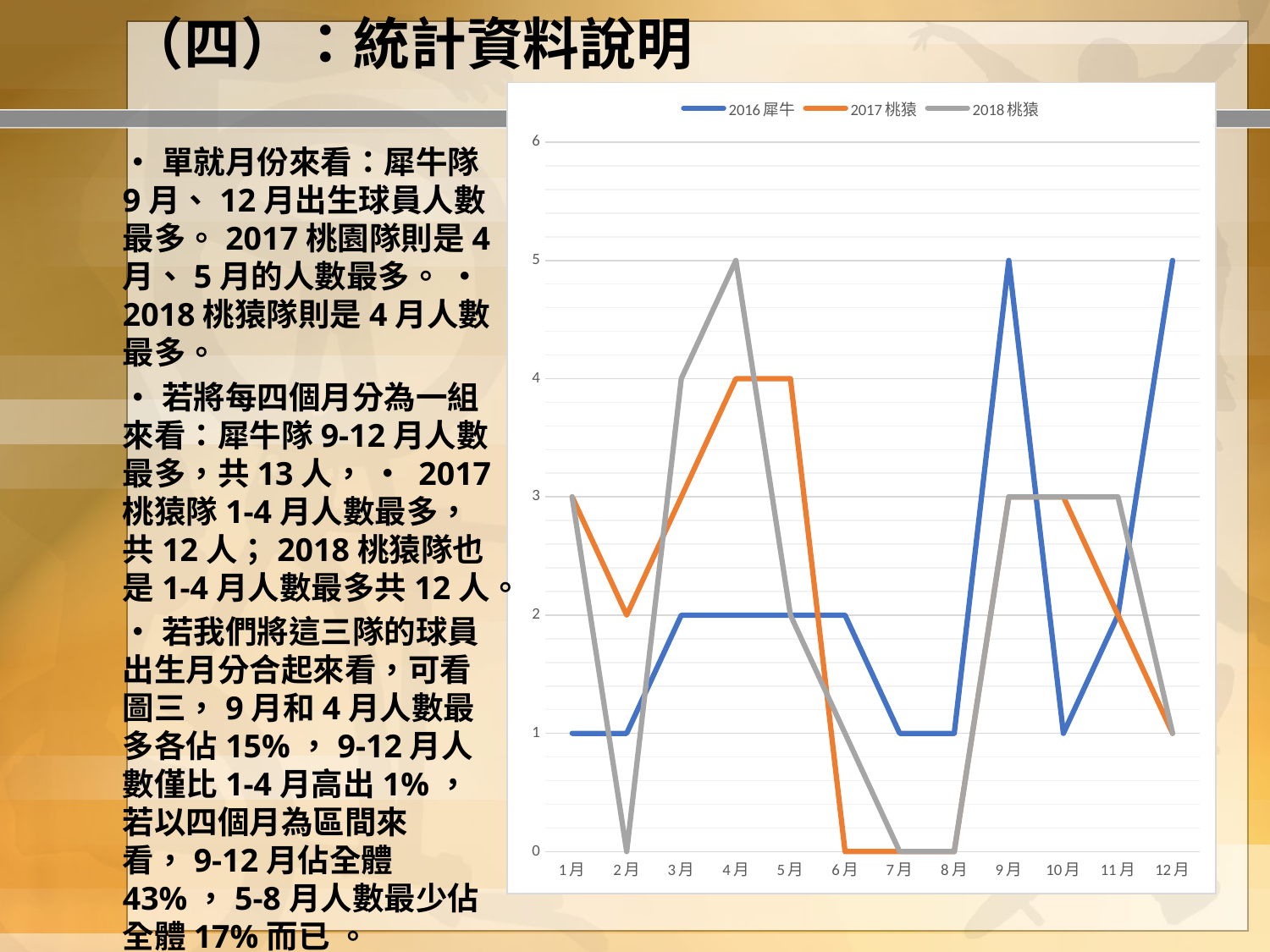
What is the value for 2018 桃猿 in 4月? 5 How many series does the chart legend list? 3 How many months are shown along the x axis of the chart? 12 In which month does 2018 桃猿 reach its highest value? 4月 Which series has the higher value in 4月, 2016 犀牛 or 2017 桃猿? 2017 桃猿 What is the difference between the 2016 犀牛 value in 9月 and its value in 10月? 4 Which series is drawn in orange in the chart? 2017 桃猿 What is the value for 2017 桃猿 in 6月? 0 What kind of chart is shown on the slide? line chart What is the value for 2016 犀牛 in 9月? 5 Is the value for 2016 犀牛 in 12月 greater or less than 4? greater In which month does 2017 桃猿 reach its highest value? 4月 and 5月